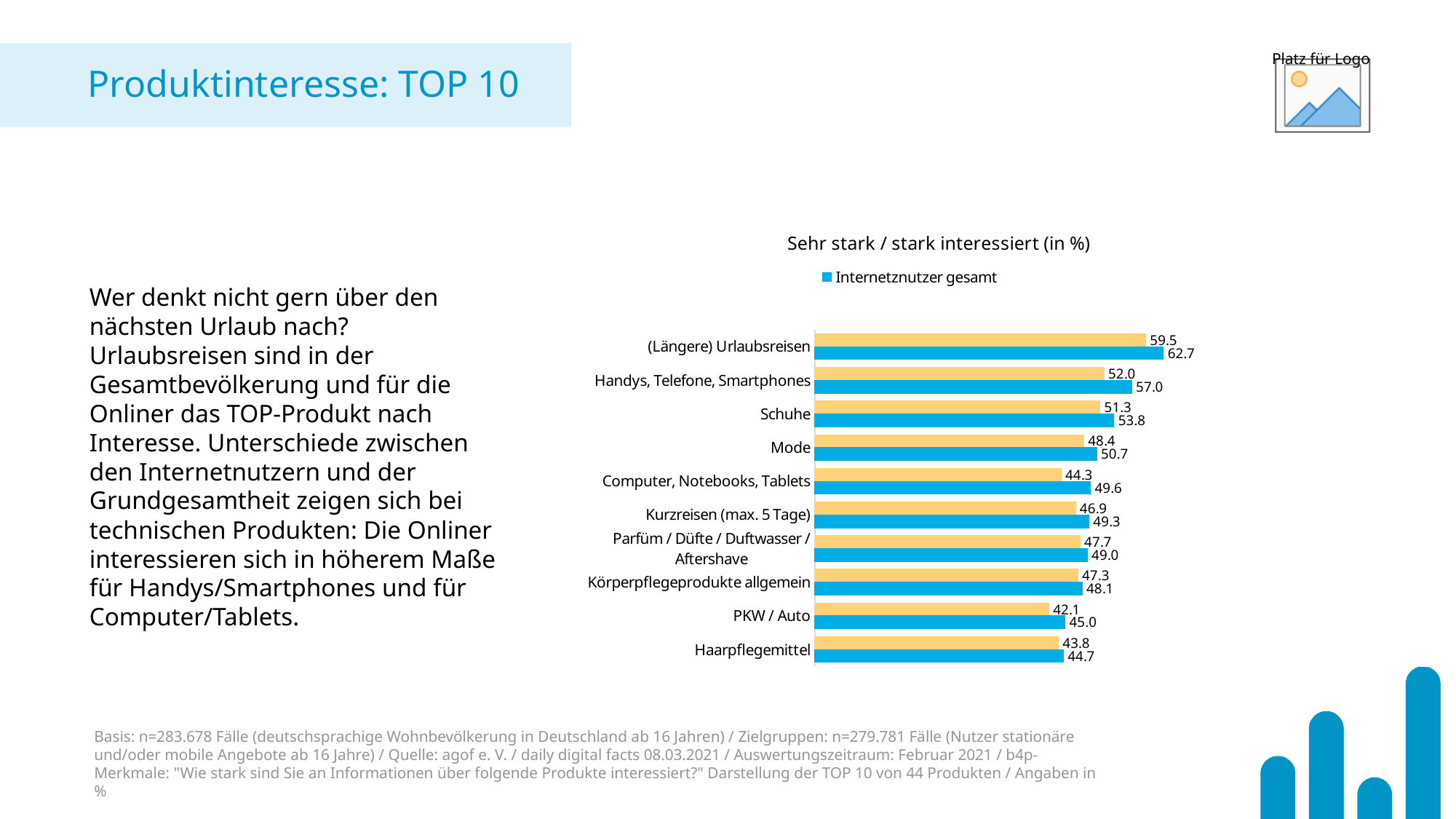
Which category has the highest value for Internetnutzer gesamt? (Längere) Urlaubsreisen What is the value for Internetnutzer gesamt for Schuhe? 53.8 What is the value of the yellow bar for PKW / Auto? 42.1 What is the difference between the Internetnutzer gesamt value and the yellow bar value for Handys, Telefone, Smartphones? 5.0 How many product categories are shown in the chart? 10 How many series does the legend list? 1 What is the value for Internetnutzer gesamt for Haarpflegemittel? 44.7 Which category has the lowest value for Internetnutzer gesamt? Haarpflegemittel Which is larger for Internetnutzer gesamt: Mode or PKW / Auto? Mode What type of chart is shown on the slide? Bar chart What is the difference between the Internetnutzer gesamt values for (Längere) Urlaubsreisen and Schuhe? 8.9 What is the value for Internetnutzer gesamt for (Längere) Urlaubsreisen? 62.7